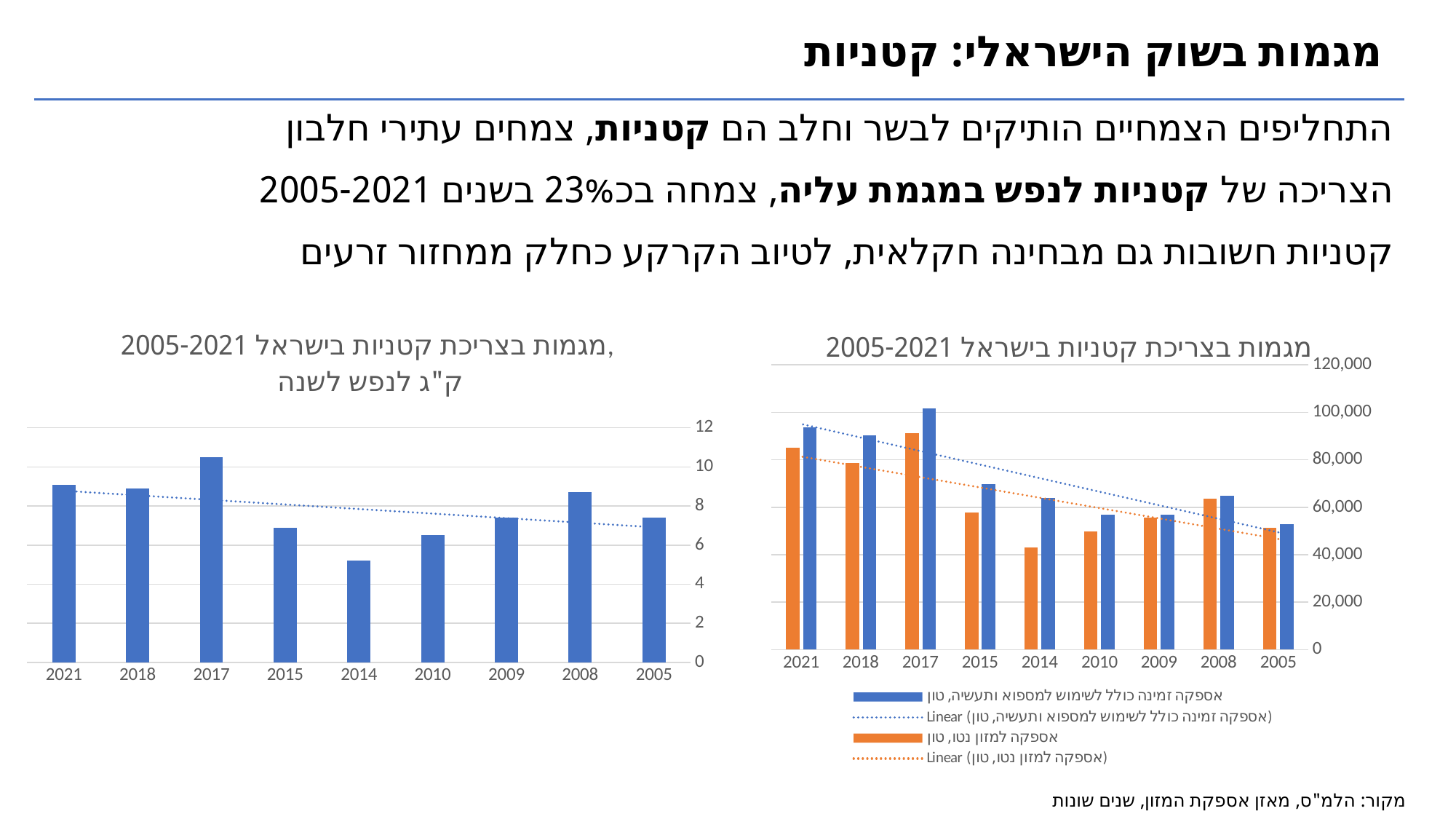
In the right chart (the one in tons), which year has the lowest orange bar (אספקה למזון נטו)? 2014 In the left chart (ק"ג לנפש לשנה), which year has the lowest bar? 2014 In the left chart (ק"ג לנפש לשנה), is the value for 2014 greater or less than 6? less In the left chart (ק"ג לנפש לשנה), which year has the highest bar? 2017 In the left chart (ק"ג לנפש לשנה), which is larger, the value for 2021 or the value for 2015? 2021 In the right chart (the one in tons), is the orange bar (אספקה למזון נטו) for 2014 greater or less than 60,000? less How many entries does the legend of the right chart (the one in tons) list? 4 In the right chart (the one in tons), which year has the highest blue bar (אספקה זמינה כולל לשימוש למספוא ותעשיה)? 2017 In the left chart (ק"ג לנפש לשנה), is the value for 2021 greater or less than 8? greater How many years are shown on the x axis of the left chart (ק"ג לנפש לשנה)? 9 In the right chart (the one in tons), which is larger for 2021, the blue bar or the orange bar? the blue bar What kind of chart is the left chart (ק"ג לנפש לשנה)? bar chart